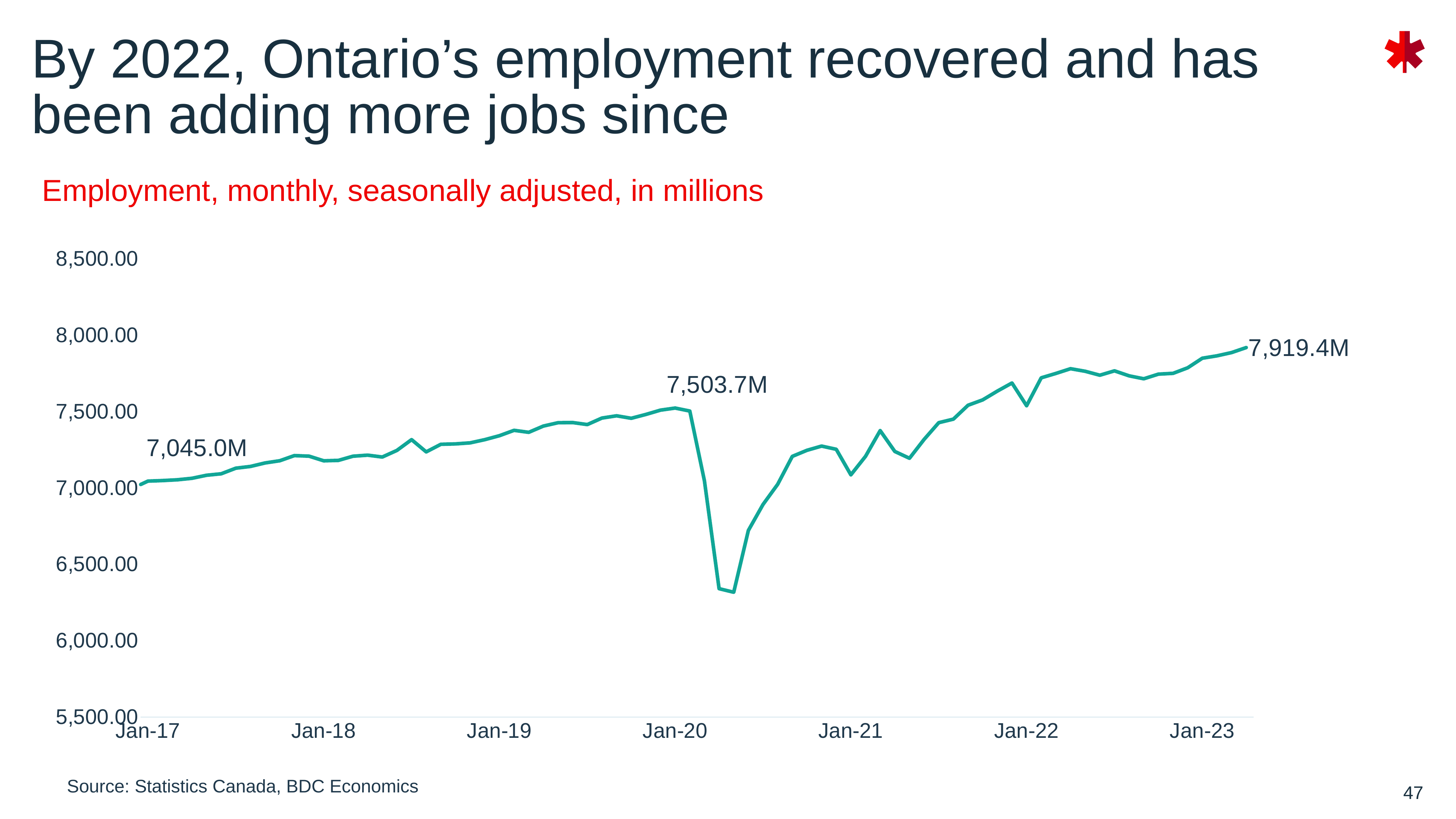
What kind of chart is shown on the slide? line chart Which is larger: the labelled value at the start of the series or the labelled value at the end of the series? the end of the series (7,919.4M) What is the difference between the last labelled value (7,919.4M) and the pre-drop labelled value (7,503.7M)? 415.7M What is the difference between the last labelled value (7,919.4M) and the first labelled value (7,045.0M)? 874.4M Overall, does employment rise or fall from Jan-17 to the end of the series? rise What is the labelled value at the peak just before the sharp drop in 2020? 7,503.7M What is the subtitle describing the data plotted in the chart? Employment, monthly, seasonally adjusted, in millions What is the labelled value at the end of the line, the most recent point? 7,919.4M How many year labels are shown on the x axis? 7 What is the first labelled value on the line, at the start of the series in Jan-17? 7,045.0M Is the lowest point of the line, in the 2020 trough, greater or less than 6,500.00? less